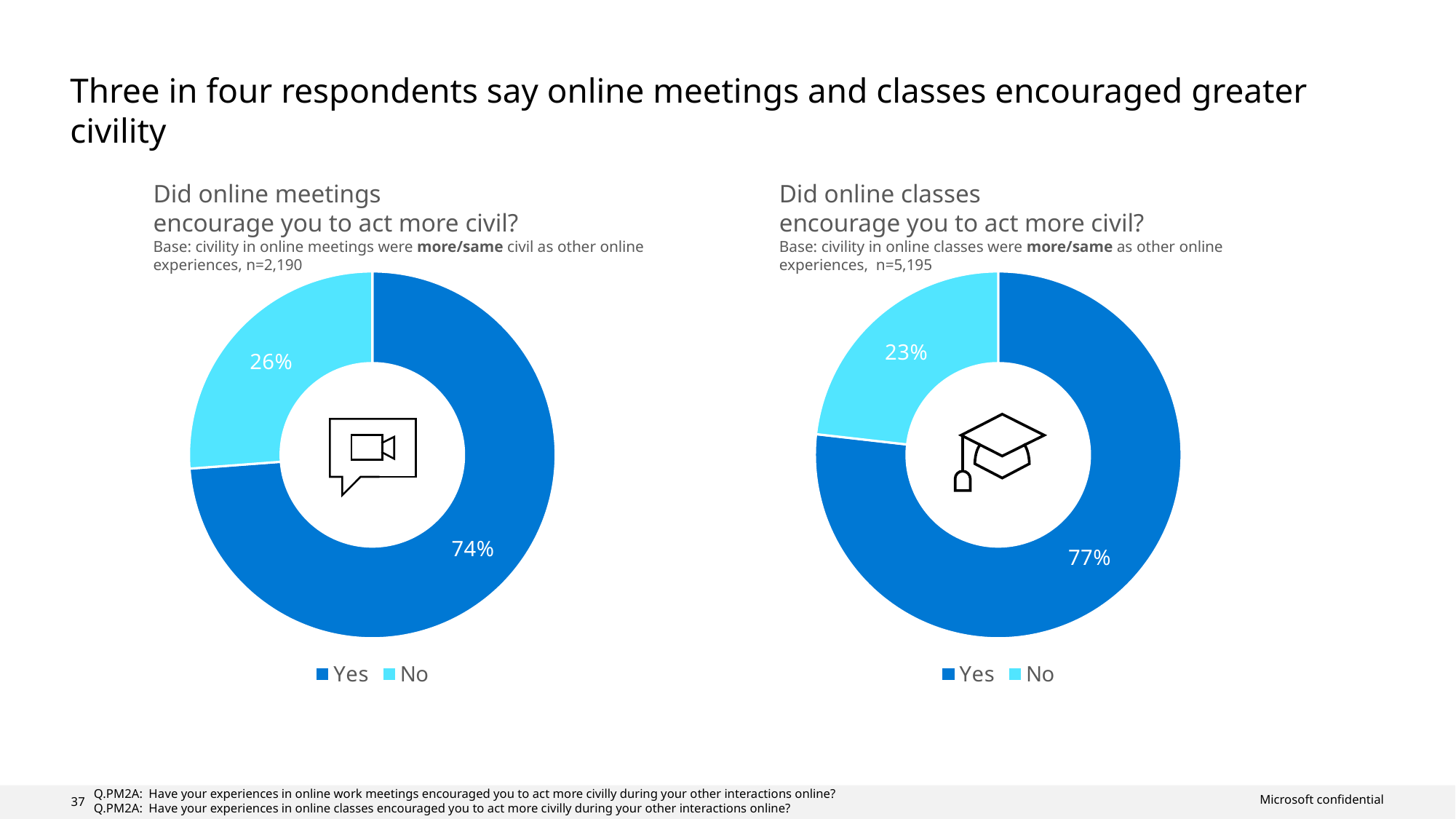
In the 'Did online meetings encourage you to act more civil?' chart, what percentage answered No? 26% In the 'Did online meetings encourage you to act more civil?' chart, what is the difference between the Yes and No percentages? 48% In the 'Did online meetings encourage you to act more civil?' chart, what percentage answered Yes? 74% Which chart has the larger Yes share, the online meetings chart or the online classes chart? Online classes What type of chart is used for 'Did online meetings encourage you to act more civil?'? Pie chart (doughnut) In the 'Did online classes encourage you to act more civil?' chart, what percentage answered No? 23% In the 'Did online classes encourage you to act more civil?' chart, what percentage answered Yes? 77% In the 'Did online meetings encourage you to act more civil?' chart, what colour is the Yes slice? Dark blue In the 'Did online classes encourage you to act more civil?' chart, what is the difference between the Yes and No percentages? 54% In the 'Did online classes encourage you to act more civil?' chart, which response has the smallest share? No How many series does the legend list in the 'Did online classes encourage you to act more civil?' chart? 2 In the 'Did online meetings encourage you to act more civil?' chart, which response has the largest share? Yes